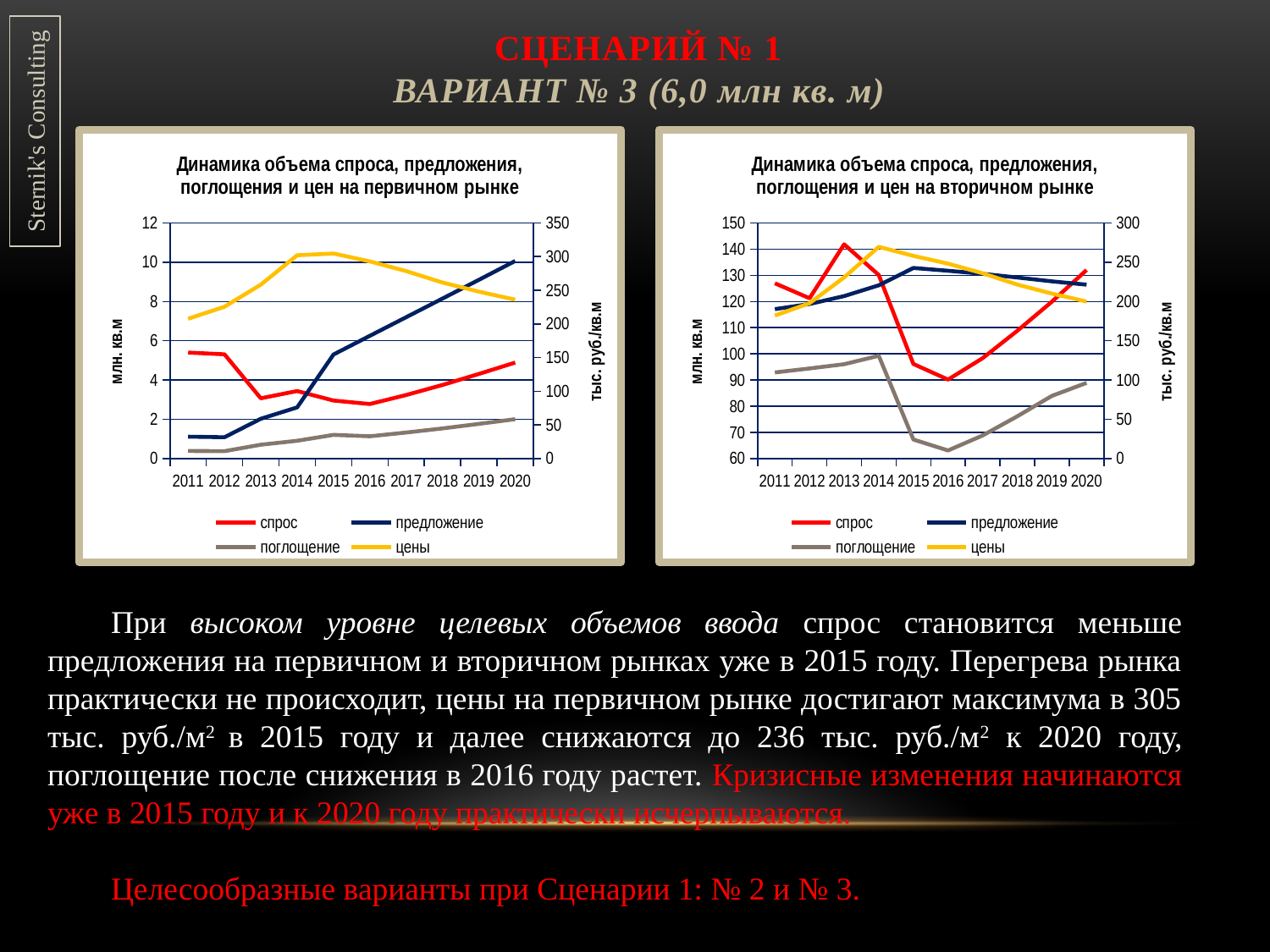
How many series does the legend of the right chart ('...на вторичном рынке') list? 4 In the left chart ('...на первичном рынке'), in which year is 'спрос' at its lowest? 2016 What kind of chart is the left chart, 'Динамика объема спроса, предложения, поглощения и цен на первичном рынке'? line chart In the right chart ('...на вторичном рынке'), in which year does 'спрос' reach its highest value? 2013 In the left chart ('...на первичном рынке'), is the value for 'предложение' in 2020 greater or less than 8 млн. кв.м? greater In the left chart ('...на первичном рынке'), does the 'предложение' line rise or fall from 2011 to 2020? rise In the right chart ('...на вторичном рынке'), in which year is 'поглощение' at its lowest? 2016 In the right chart ('...на вторичном рынке'), what colour is the 'цены' line? yellow In the left chart ('...на первичном рынке'), in which year does the 'цены' line reach its highest value? 2015 How many years are shown on the x axis of the left chart ('...на первичном рынке')? 10 In the left chart ('...на первичном рынке'), which is larger in 2020: 'спрос' or 'предложение'? предложение In the right chart ('...на вторичном рынке'), is the value for 'спрос' in 2016 greater or less than 100 млн. кв.м? less